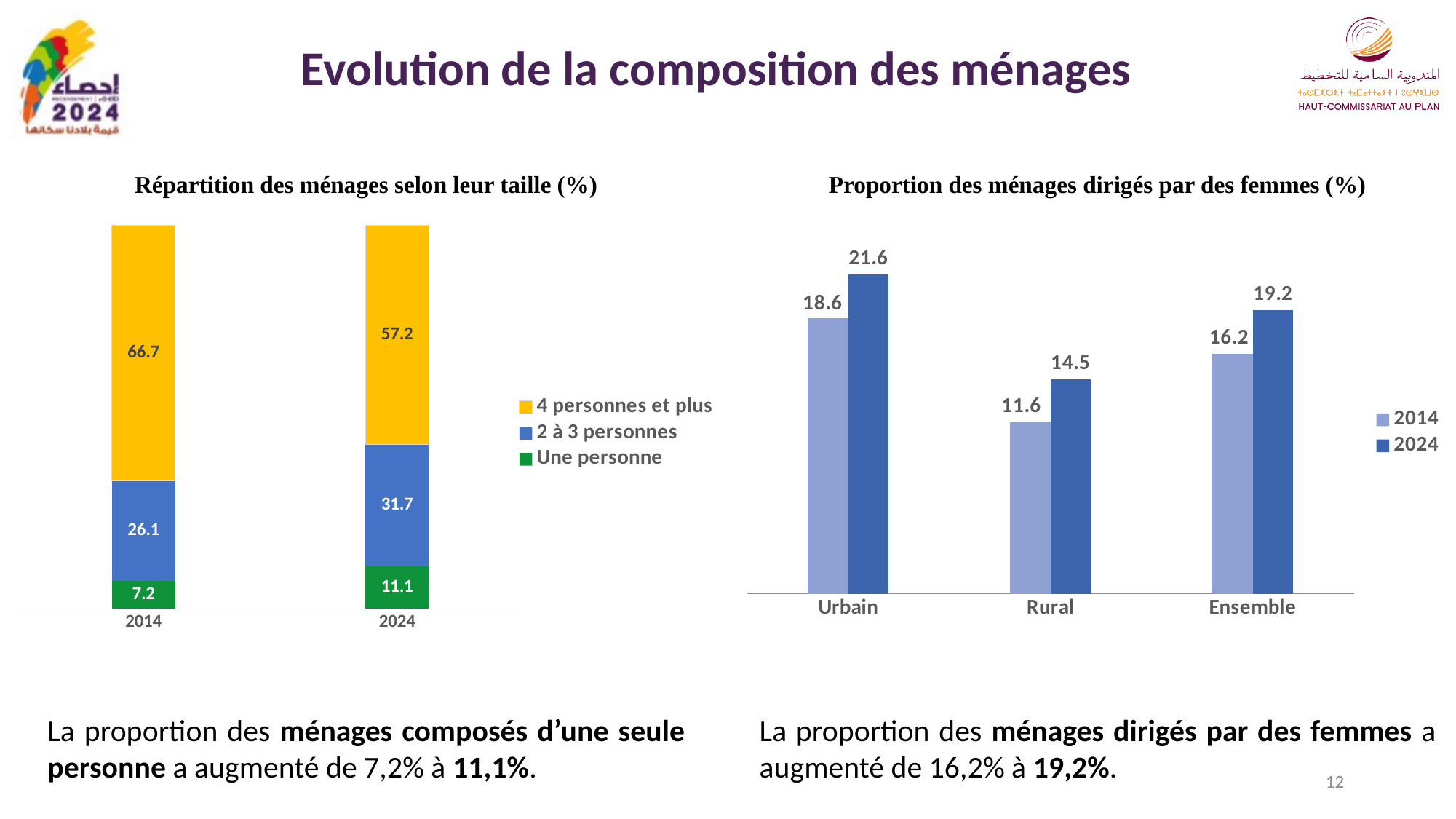
In the chart 'Répartition des ménages selon leur taille (%)', what is the total of the stacked bar for 2024? 100 In the chart 'Proportion des ménages dirigés par des femmes (%)', what is the difference between the 2024 and 2014 values for Urbain? 3.0 In the chart 'Proportion des ménages dirigés par des femmes (%)', which category has the highest value in 2024? Urbain In the chart 'Répartition des ménages selon leur taille (%)', what is the value for '4 personnes et plus' in 2014? 66.7 In the chart 'Proportion des ménages dirigés par des femmes (%)', which category has the lowest value in 2014? Rural In the chart 'Proportion des ménages dirigés par des femmes (%)', what is the value for Rural in 2024? 14.5 What kind of chart is 'Proportion des ménages dirigés par des femmes (%)'? Bar chart In the chart 'Répartition des ménages selon leur taille (%)', by how much did the '2 à 3 personnes' share change from 2014 to 2024? 5.6 In the chart 'Répartition des ménages selon leur taille (%)', what is the value for 'Une personne' in 2024? 11.1 In the chart 'Répartition des ménages selon leur taille (%)', how many series does the legend list? 3 In the chart 'Proportion des ménages dirigés par des femmes (%)', how many categories are shown on the x axis? 3 In the chart 'Répartition des ménages selon leur taille (%)', which colour represents '4 personnes et plus'? Yellow